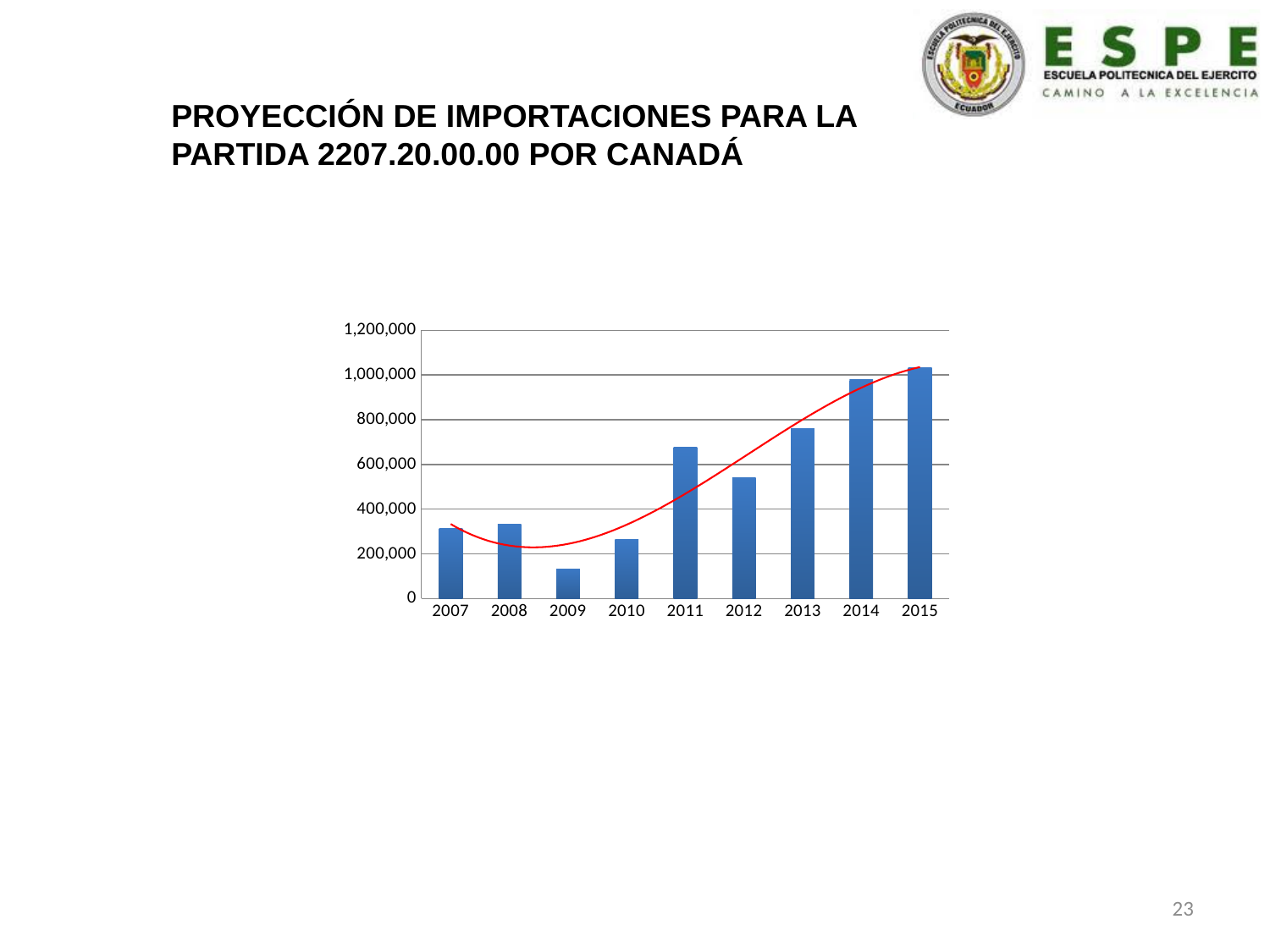
Which year has the larger value, 2011 or 2012? 2011 Is the value for 2009 greater or less than 200,000? less How many years are shown on the x axis of the chart? 9 Do the values generally rise or fall from 2010 to 2015? rise Which year has the larger value, 2010 or 2013? 2013 What kind of chart is shown on the slide? bar chart Which year has the highest bar in the chart? 2015 What colour is the trend line drawn over the bars? red Is the value for 2015 greater or less than 1,000,000? greater Is the value for 2011 greater or less than 600,000? greater Which year has the lowest bar in the chart? 2009